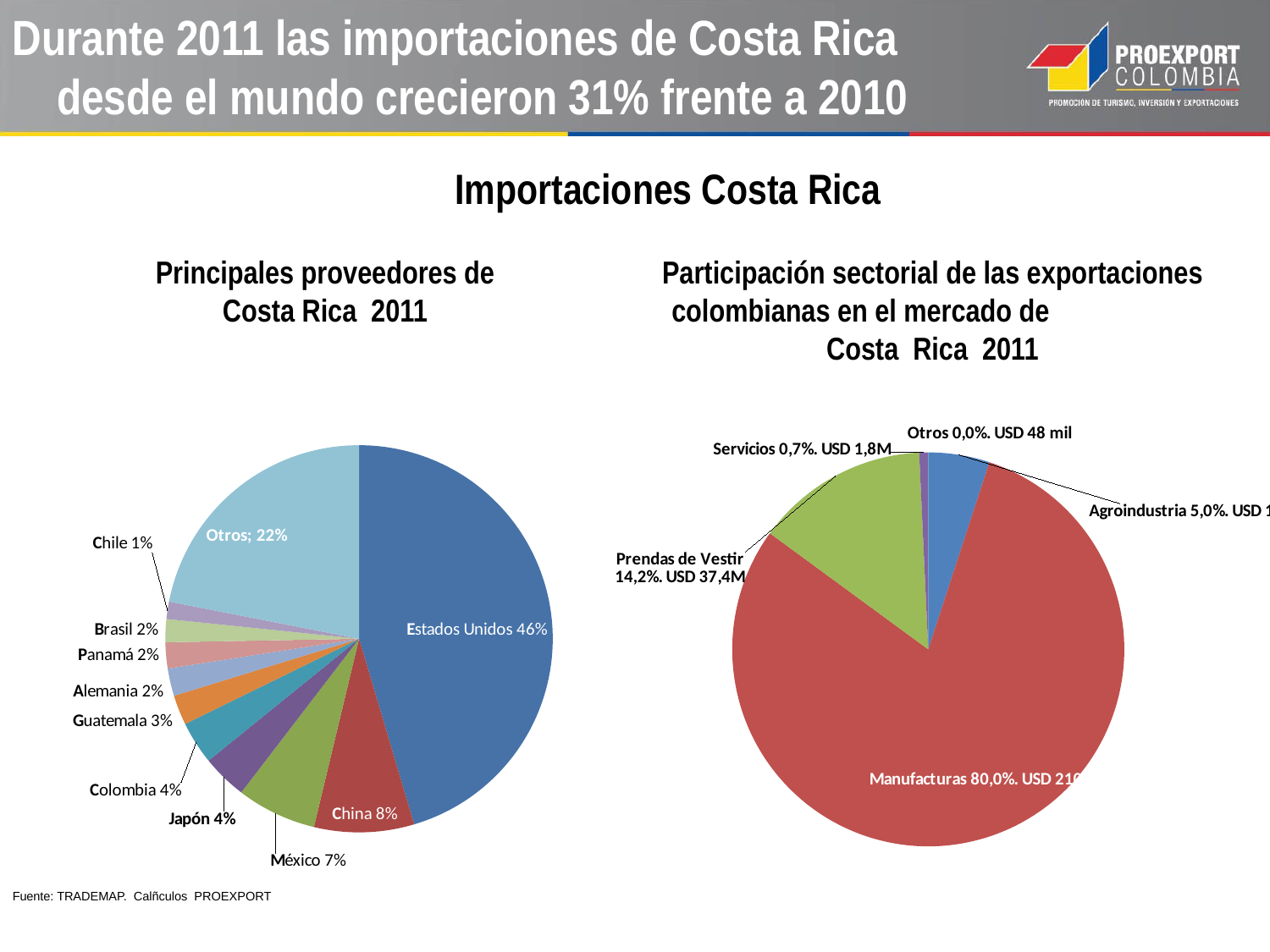
In the left pie chart (Principales proveedores de Costa Rica 2011), which has a larger share, Guatemala or Colombia? Colombia In the left pie chart (Principales proveedores de Costa Rica 2011), which country has the smallest share? Chile What type of chart is used for the Principales proveedores de Costa Rica 2011 data? Pie chart In the left pie chart (Principales proveedores de Costa Rica 2011), what share does China have? 8% In the left pie chart (Principales proveedores de Costa Rica 2011), what is the difference between the shares of China and México? 1% In the left pie chart (Principales proveedores de Costa Rica 2011), what share does Estados Unidos have? 46% In the right pie chart (Participación sectorial de las exportaciones colombianas en el mercado de Costa Rica 2011), which sector has the largest share? Manufacturas How many slices does the left pie chart (Principales proveedores de Costa Rica 2011) have? 11 In the left pie chart (Principales proveedores de Costa Rica 2011), what share does Otros have? 22% In the right pie chart (Participación sectorial de las exportaciones colombianas en el mercado de Costa Rica 2011), what is the USD value shown for Servicios? USD 1,8M In the left pie chart (Principales proveedores de Costa Rica 2011), which slice is the largest? Estados Unidos In the right pie chart (Participación sectorial de las exportaciones colombianas en el mercado de Costa Rica 2011), what share does Prendas de Vestir have? 14,2%